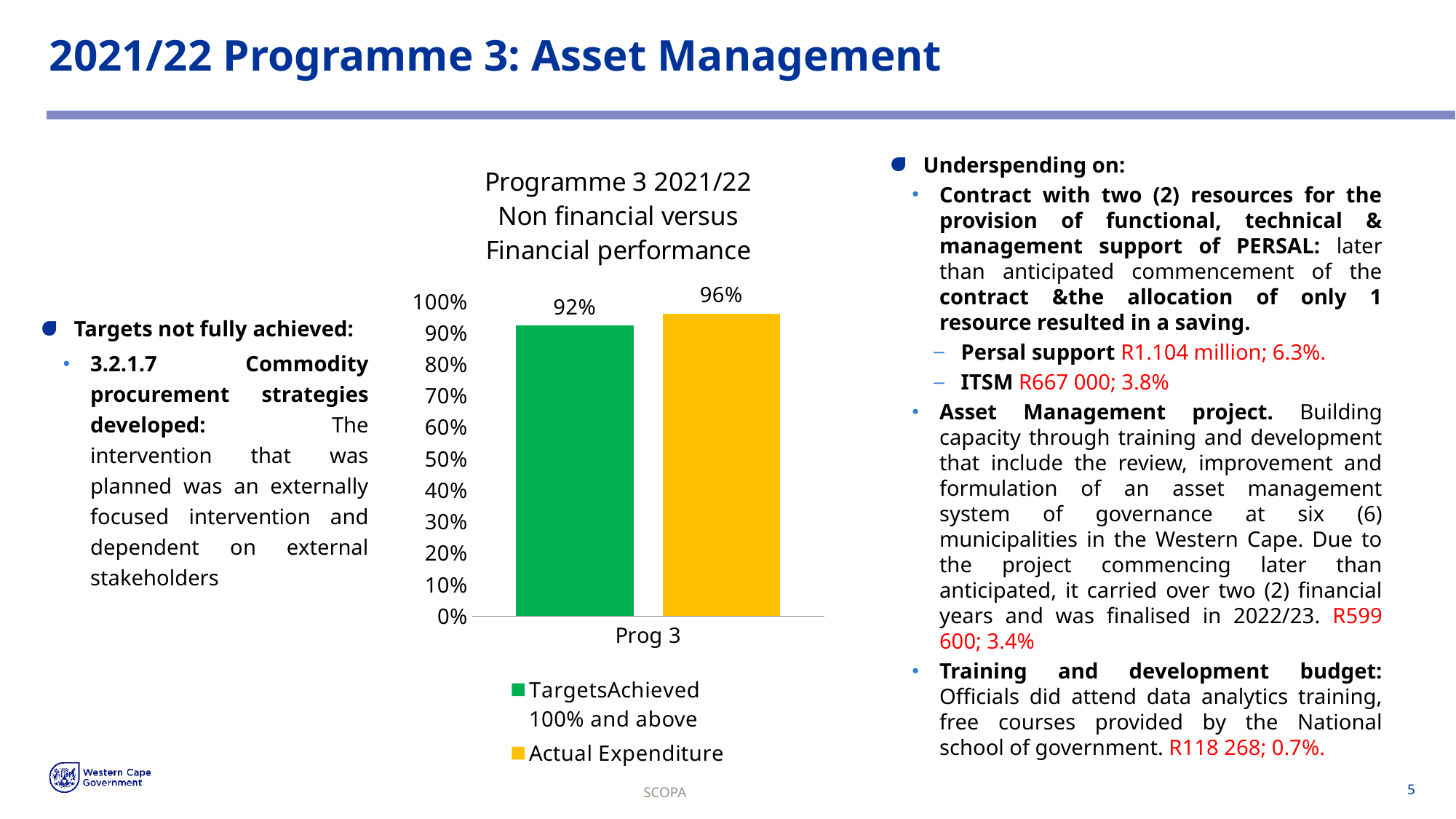
What is the category label on the x axis? Prog 3 How many series does the legend list? 2 What kind of chart is shown on the slide? Bar chart What is the value of Actual Expenditure for Prog 3? 96% What is the value of Targets Achieved 100% and above for Prog 3? 92% What colour is the Actual Expenditure bar? Yellow How many categories are shown on the x axis? 1 What is the difference between Actual Expenditure and Targets Achieved 100% and above for Prog 3? 4% Is the value for Actual Expenditure greater or less than 100%? less Is the value for Targets Achieved 100% and above greater or less than 90%? greater Which series has the higher value for Prog 3, Targets Achieved 100% and above or Actual Expenditure? Actual Expenditure What is the title of the chart? Programme 3 2021/22 Non financial versus Financial performance